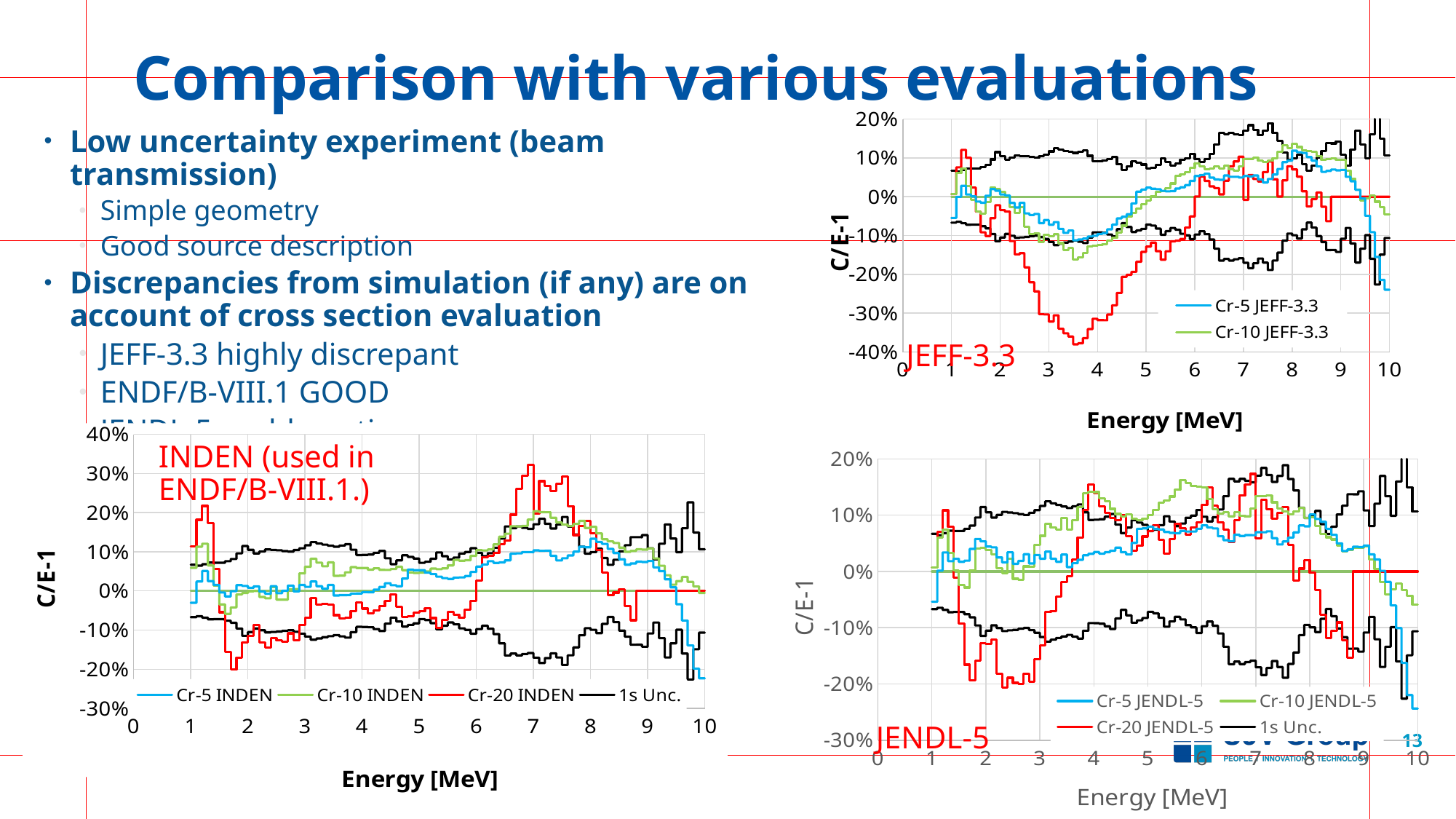
How many series are listed in the legend of the JEFF-3.3 chart at the top right? 2 What is the x-axis label of the JENDL-5 chart? Energy [MeV] What is the y-axis label of the INDEN chart? C/E-1 In the INDEN chart, does the Cr-5 INDEN line rise or fall between 9 MeV and 10 MeV? fall In the JENDL-5 chart, is the value of the Cr-5 JENDL-5 line at 10 MeV greater or less than -20%? less In the INDEN chart, is the value of the Cr-5 INDEN line at 10 MeV greater or less than -10%? less In the JEFF-3.3 chart, which series is shown in blue according to the legend? Cr-5 JEFF-3.3 What kind of chart is the INDEN chart at the bottom left of the slide? line chart In the JEFF-3.3 chart, is the lowest value of the red Cr-20 line (near 3.5 MeV) greater or less than -30%? less How many series does the legend of the JENDL-5 chart list? 4 How many series does the legend of the INDEN chart list? 4